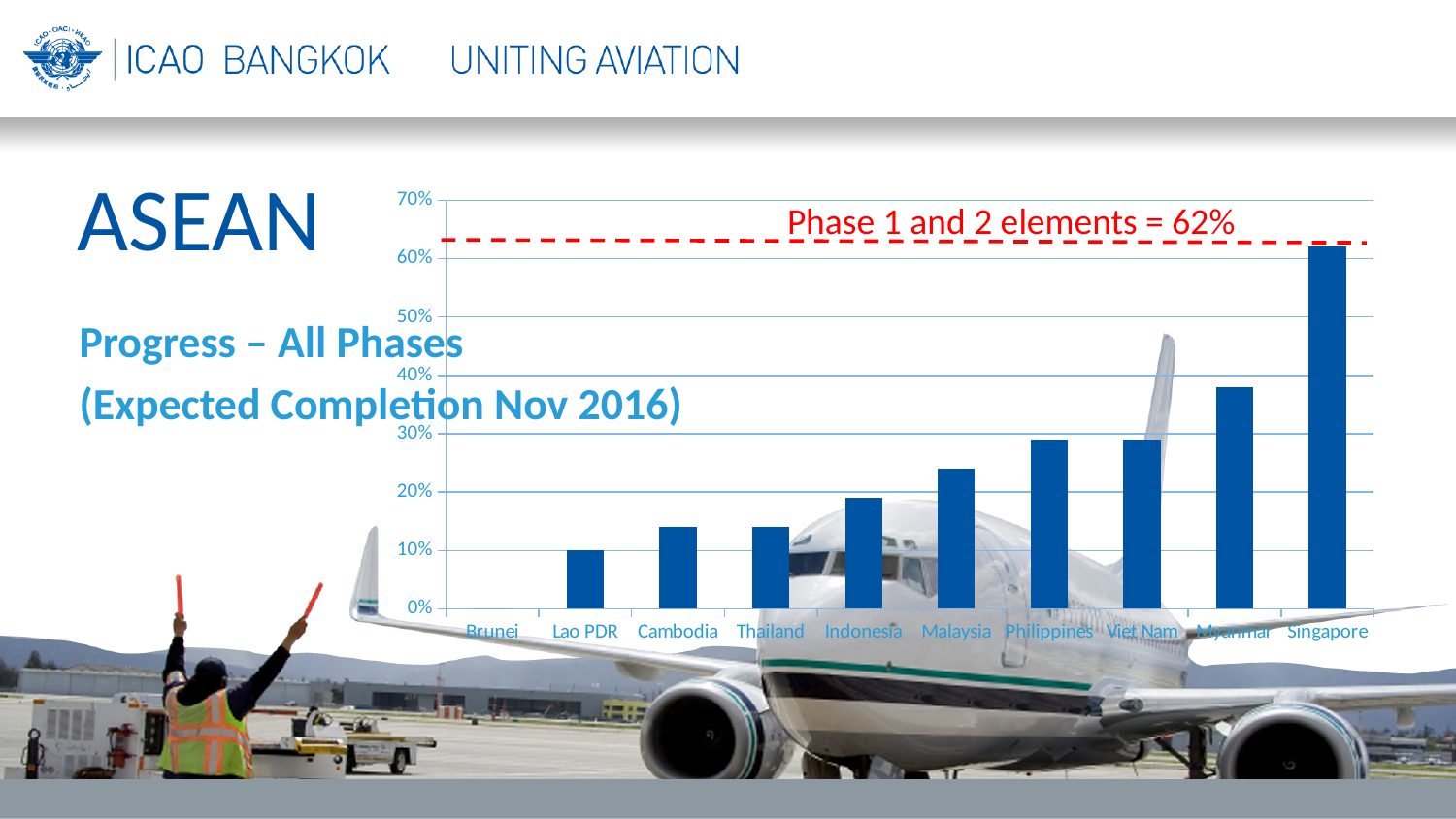
Which is larger, the value for Myanmar or the value for Philippines? Myanmar Is the value for Singapore greater or less than 60%? greater Which country has the lowest value in the chart? Brunei What does the label on the red dashed line in the chart say? Phase 1 and 2 elements = 62% Is the value for Malaysia greater or less than 20%? greater Which country has the highest bar in the chart? Singapore What is the highest value shown on the chart's y axis? 70% How many countries are shown along the x axis of the chart? 10 What kind of chart is shown on the slide? bar chart Is the value for Myanmar greater or less than 40%? less Do the bar values generally rise or fall from left to right across the x axis? rise